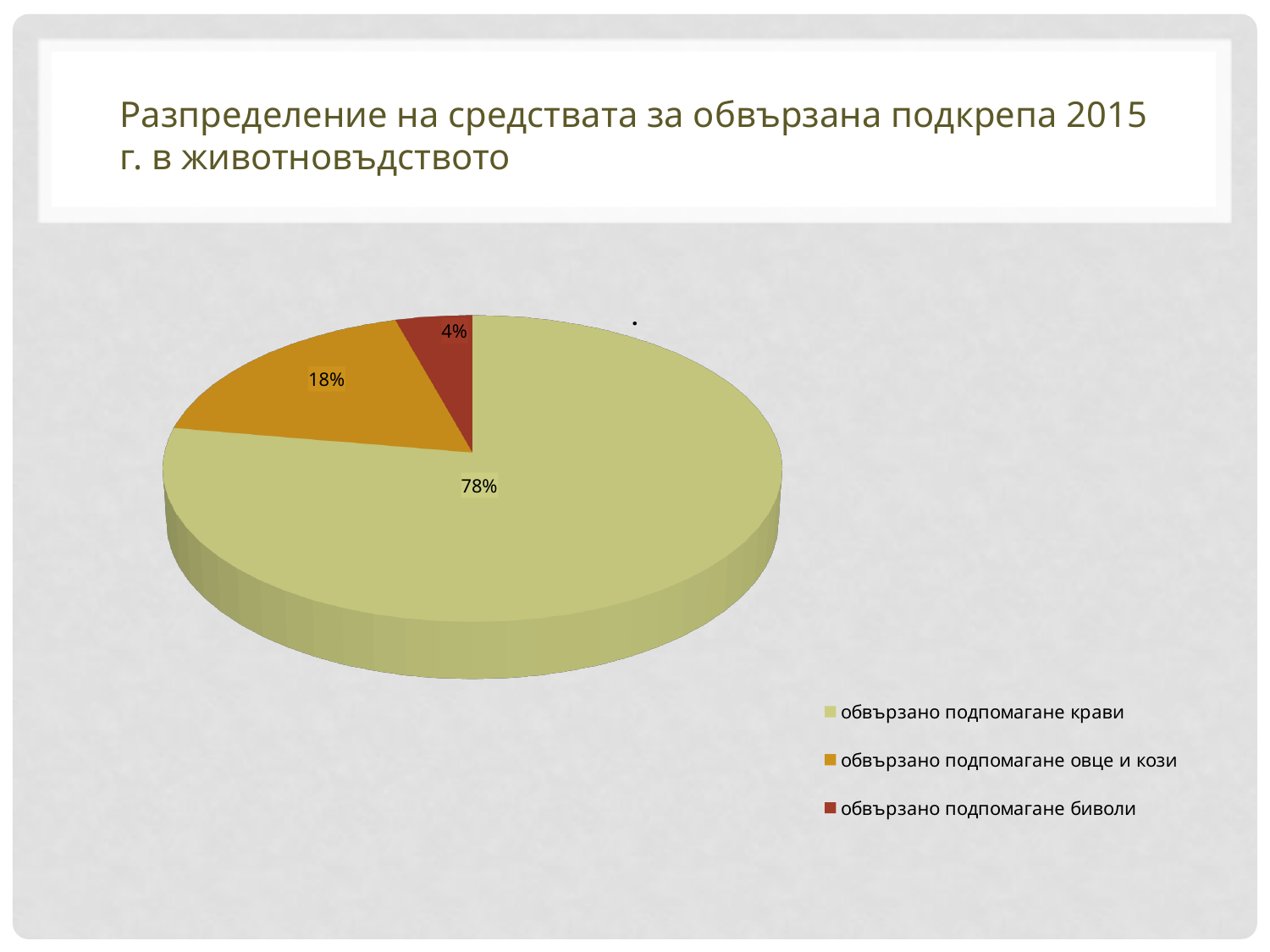
What is the title of the slide? Разпределение на средствата за обвързана подкрепа 2015 г. в животновъдството What share of the pie does "обвързано подпомагане биволи" have? 4% How many entries does the legend list? 3 Which category has the largest slice of the pie? обвързано подпомагане крави What share of the pie does "обвързано подпомагане крави" have? 78% Which is larger: the slice for "обвързано подпомагане овце и кози" or the slice for "обвързано подпомагане биволи"? обвързано подпомагане овце и кози What is the difference in percentage points between the slice for "обвързано подпомагане крави" and the slice for "обвързано подпомагане овце и кози"? 60 Which category has the smallest slice of the pie? обвързано подпомагане биволи What kind of chart is shown on the slide? pie chart What colour is the slice for "обвързано подпомагане биволи"? dark red How many slices does the pie chart have? 3 What share of the pie does "обвързано подпомагане овце и кози" have? 18%